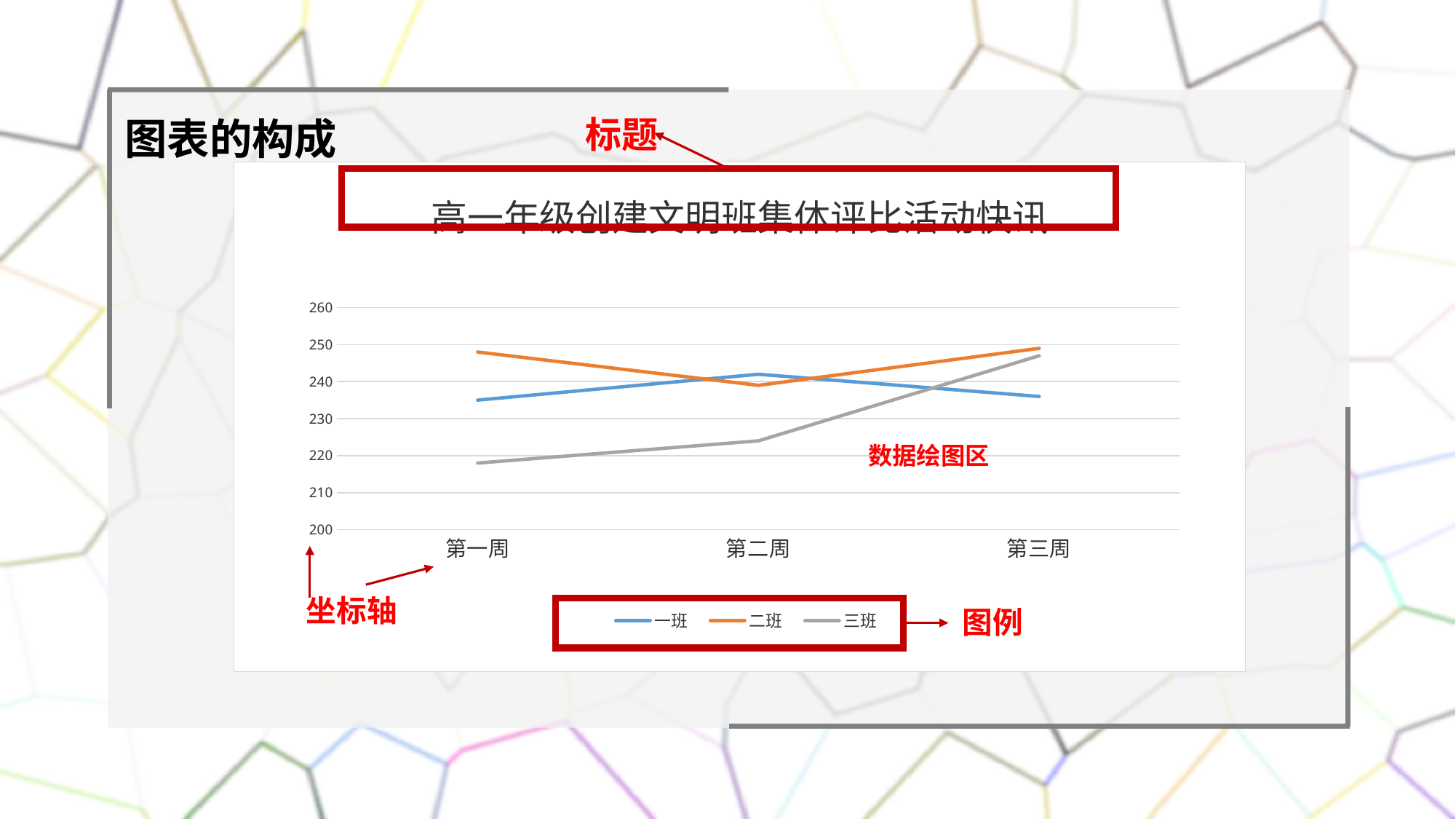
What is the title of the chart? 高一年级创建文明班集体评比活动快讯 Is the value for 三班 at 第一周 greater or less than 230? less How many series does the chart's legend list? 3 At 第二周, which is larger: the value for 一班 or the value for 三班? 一班 What kind of chart is shown on the slide? line chart Which series is drawn in orange in the chart? 二班 Is the value for 二班 at 第三周 greater or less than 240? greater Which series has the lowest value at 第一周? 三班 Which series has the highest value at 第一周? 二班 Does the value for 三班 rise or fall from 第一周 to 第三周? rise Which series has the lowest value at 第三周? 一班 How many categories are shown on the x axis of the chart? 3